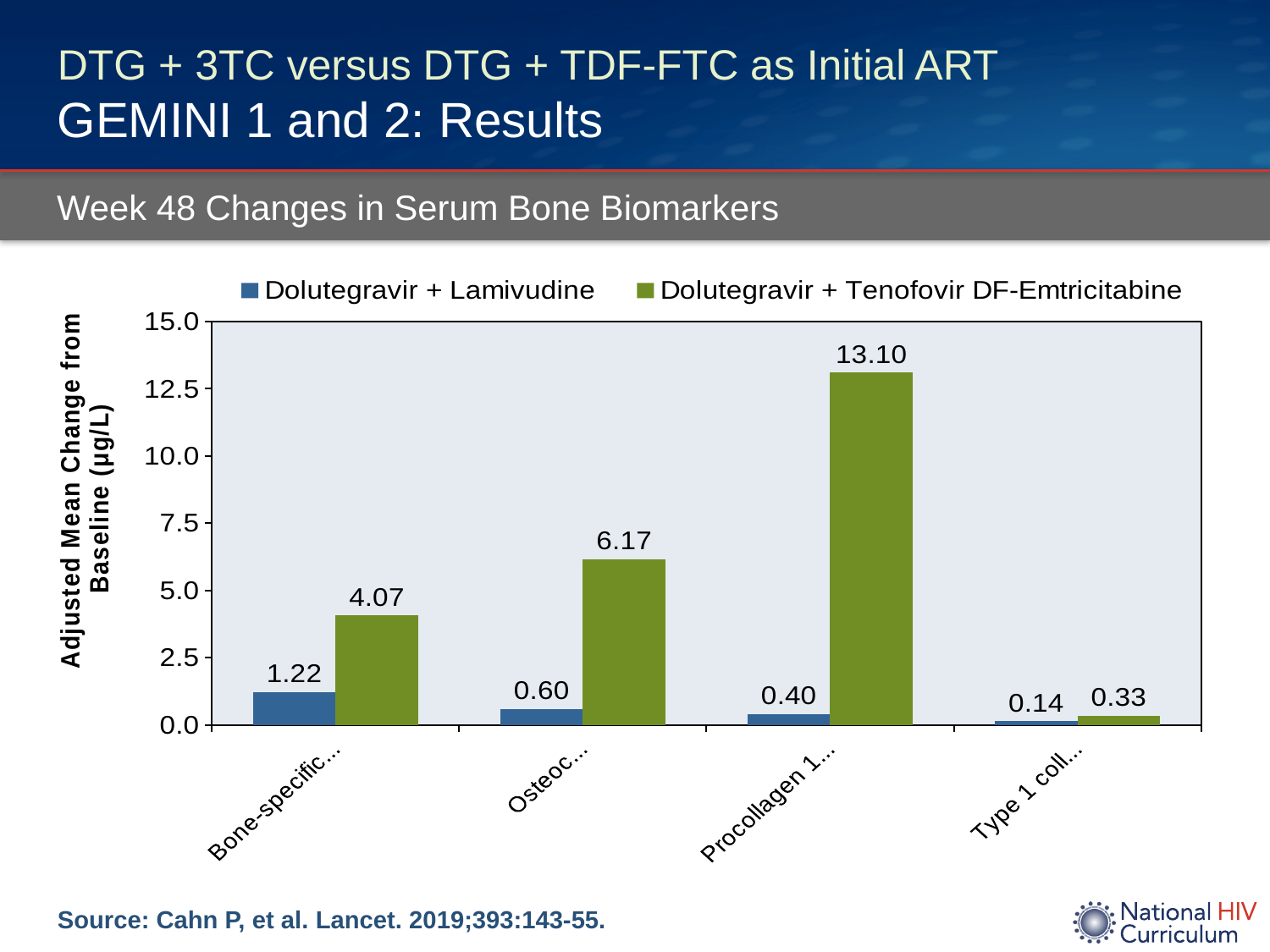
What is the y-axis label of the chart? Adjusted Mean Change from Baseline (µg/L) In which category is the Dolutegravir + Tenofovir DF-Emtricitabine value highest? Procollagen 1... (third category) What is the value for Dolutegravir + Lamivudine in the first category (labelled "Bone-specific...")? 1.22 What is the value for Dolutegravir + Tenofovir DF-Emtricitabine in the second category (labelled "Osteoc...")? 6.17 In which category is the Dolutegravir + Lamivudine value lowest? Type 1 coll... (fourth category) In the first category (labelled "Bone-specific..."), which series has the larger value? Dolutegravir + Tenofovir DF-Emtricitabine What is the value for Dolutegravir + Lamivudine in the fourth category (labelled "Type 1 coll...")? 0.14 What is the value for Dolutegravir + Tenofovir DF-Emtricitabine in the third category (labelled "Procollagen 1...")? 13.10 How many biomarker categories are shown on the x axis of the chart? 4 What is the difference between the two series' values in the third category (labelled "Procollagen 1...")? 12.70 What kind of chart is shown on the slide? bar chart How many series does the chart legend list? 2